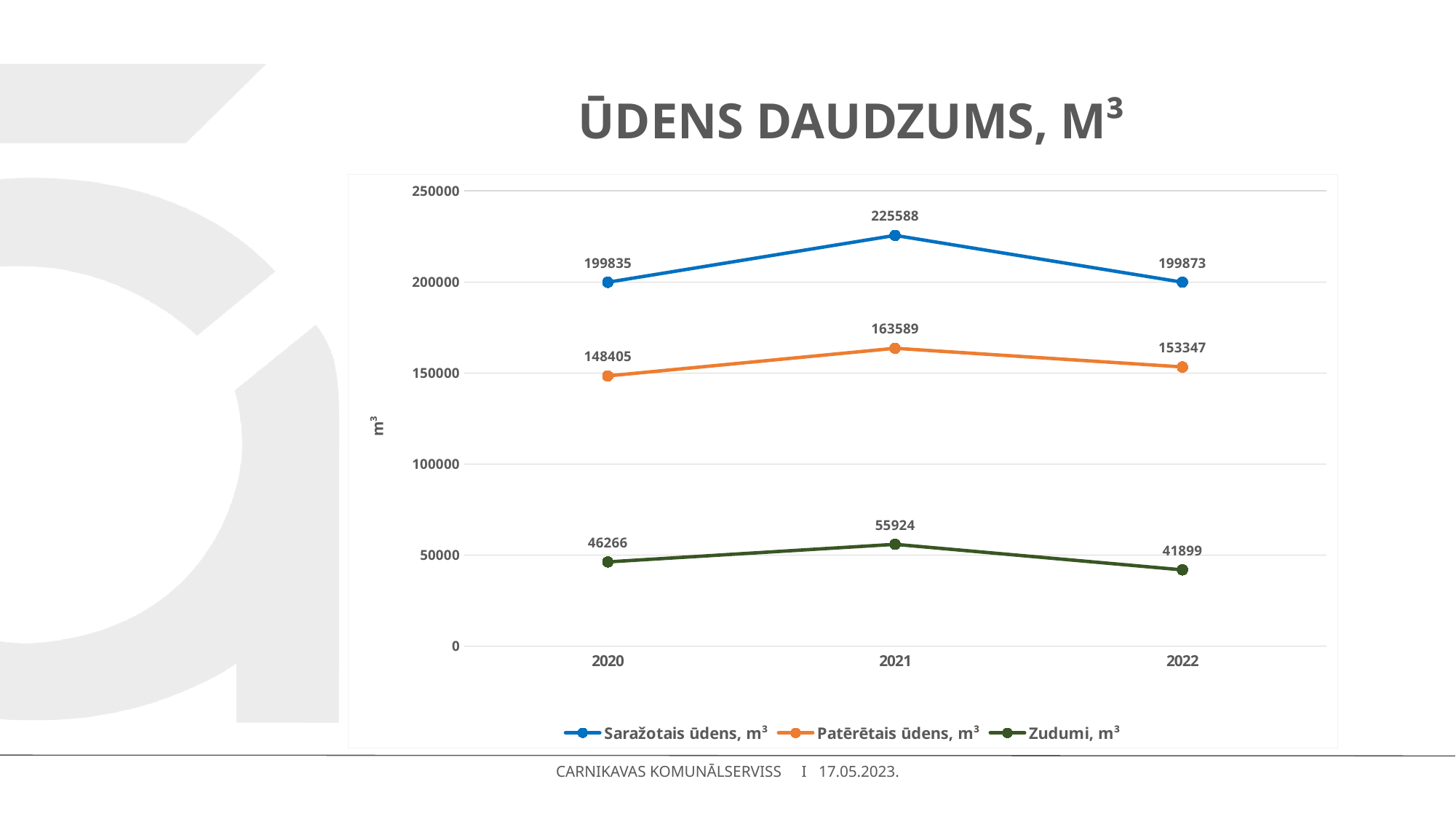
Which is larger: Patērētais ūdens, m³ in 2022 or in 2020? 2022 How many series does the legend list? 3 What is the value of Zudumi, m³ in 2022? 41899 What is the difference between Patērētais ūdens, m³ in 2021 and in 2020? 15184 In which year is Saražotais ūdens, m³ highest? 2021 What type of chart is shown on the slide? line chart What is the difference between Saražotais ūdens, m³ in 2021 and in 2020? 25753 What is the value of Saražotais ūdens, m³ in 2021? 225588 What is the value of Patērētais ūdens, m³ in 2020? 148405 How many years are shown on the x axis? 3 In which year is Zudumi, m³ lowest? 2022 What is the title of the chart? ŪDENS DAUDZUMS, M³